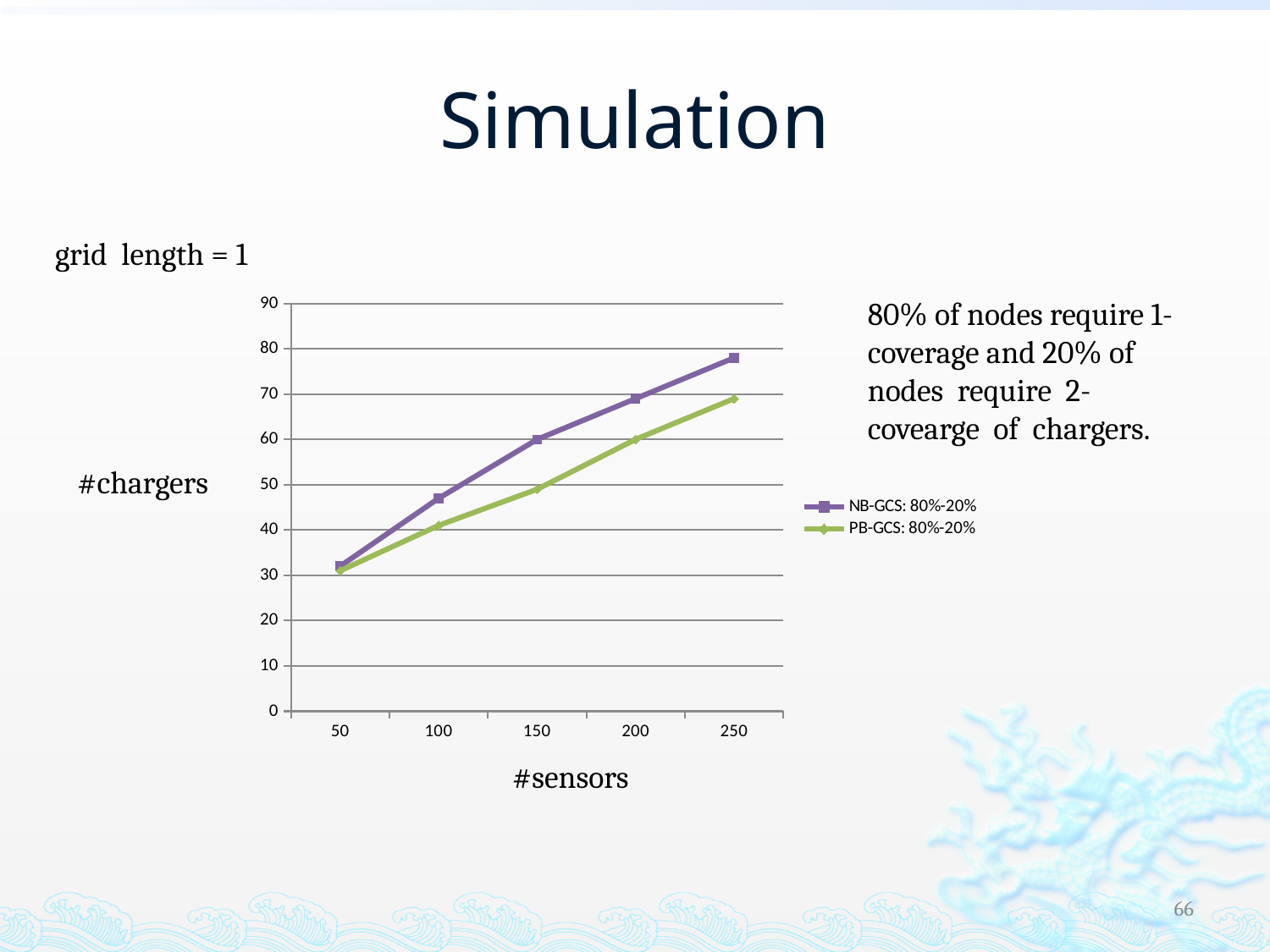
Is the value for NB-GCS: 80%-20% at 100 sensors greater or less than 40? greater Does the NB-GCS: 80%-20% series rise or fall as the number of sensors increases? rise At 200 sensors, which series has the higher number of chargers? NB-GCS: 80%-20% How many #sensors values are plotted along the x axis? 5 Is the value for PB-GCS: 80%-20% at 250 sensors greater or less than 60? greater Is the value for PB-GCS: 80%-20% at 100 sensors greater or less than 50? less For the PB-GCS: 80%-20% series, at which #sensors value is the number of chargers highest? 250 How many series does the legend list? 2 What kind of chart is shown on the slide? line chart What is the label of the x axis? #sensors